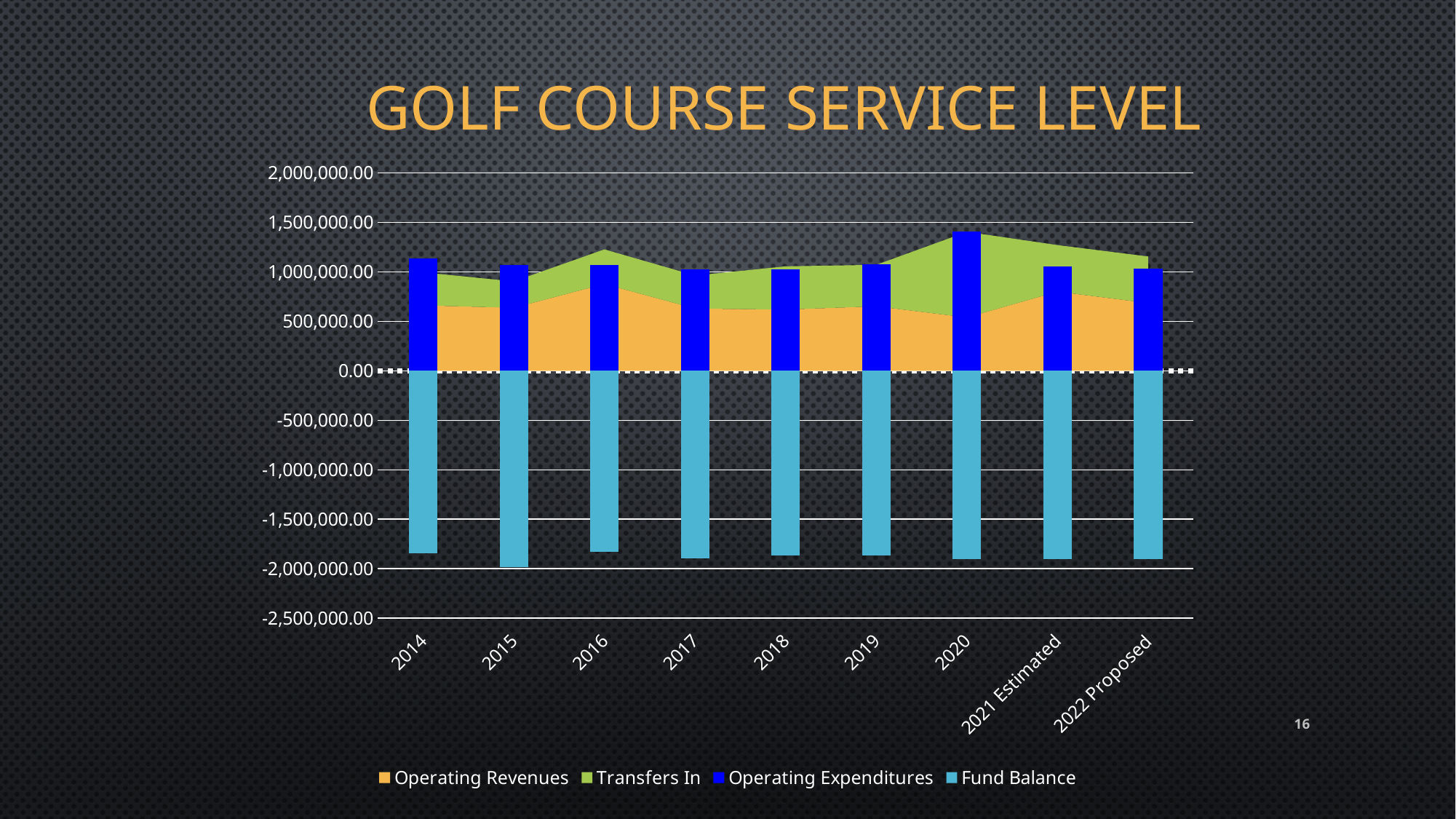
How many categories are shown on the x axis? 9 Which is larger, Operating Expenditures in 2014 or in 2017? 2014 In which year is the Fund Balance lowest (most negative)? 2015 Is the Operating Expenditures value for 2020 greater or less than 1,000,000.00? greater Which is larger, Operating Expenditures in 2020 or in 2021 Estimated? 2020 Is the Fund Balance value for 2014 greater or less than -1,500,000.00? less What is the title of the chart? GOLF COURSE SERVICE LEVEL Which series is shown in light blue? Fund Balance Is the Operating Expenditures value for 2014 greater or less than 1,000,000.00? greater How many series does the legend list? 4 In which year is Operating Expenditures highest? 2020